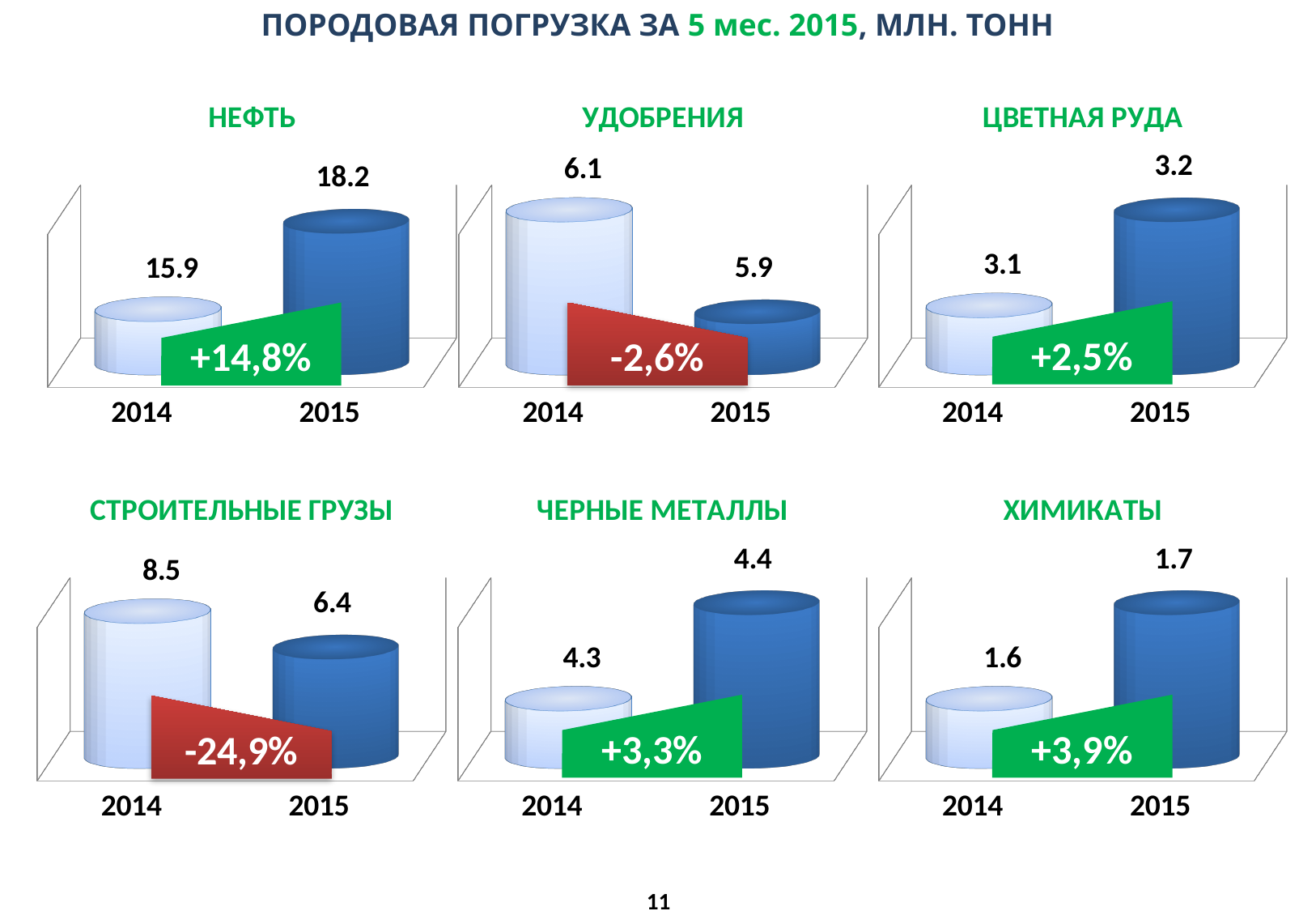
In the СТРОИТЕЛЬНЫЕ ГРУЗЫ chart, what is the value for 2014? 8.5 What kind of chart is the ХИМИКАТЫ chart? bar chart In the НЕФТЬ chart, what is the difference between the 2015 and 2014 values? 2.3 In the СТРОИТЕЛЬНЫЕ ГРУЗЫ chart, what is the difference between the 2014 and 2015 values? 2.1 In the ЧЕРНЫЕ МЕТАЛЛЫ chart, what is the value for 2015? 4.4 In the ЦВЕТНАЯ РУДА chart, what is the value for 2015? 3.2 In the ЧЕРНЫЕ МЕТАЛЛЫ chart, which year has the higher value? 2015 In the УДОБРЕНИЯ chart, what is the value for 2014? 6.1 In the СТРОИТЕЛЬНЫЕ ГРУЗЫ chart, do the values rise or fall from 2014 to 2015? fall In the ХИМИКАТЫ chart, what is the value for 2014? 1.6 In the УДОБРЕНИЯ chart, which year has the larger value, 2014 or 2015? 2014 In the НЕФТЬ chart, what is the value for 2015? 18.2